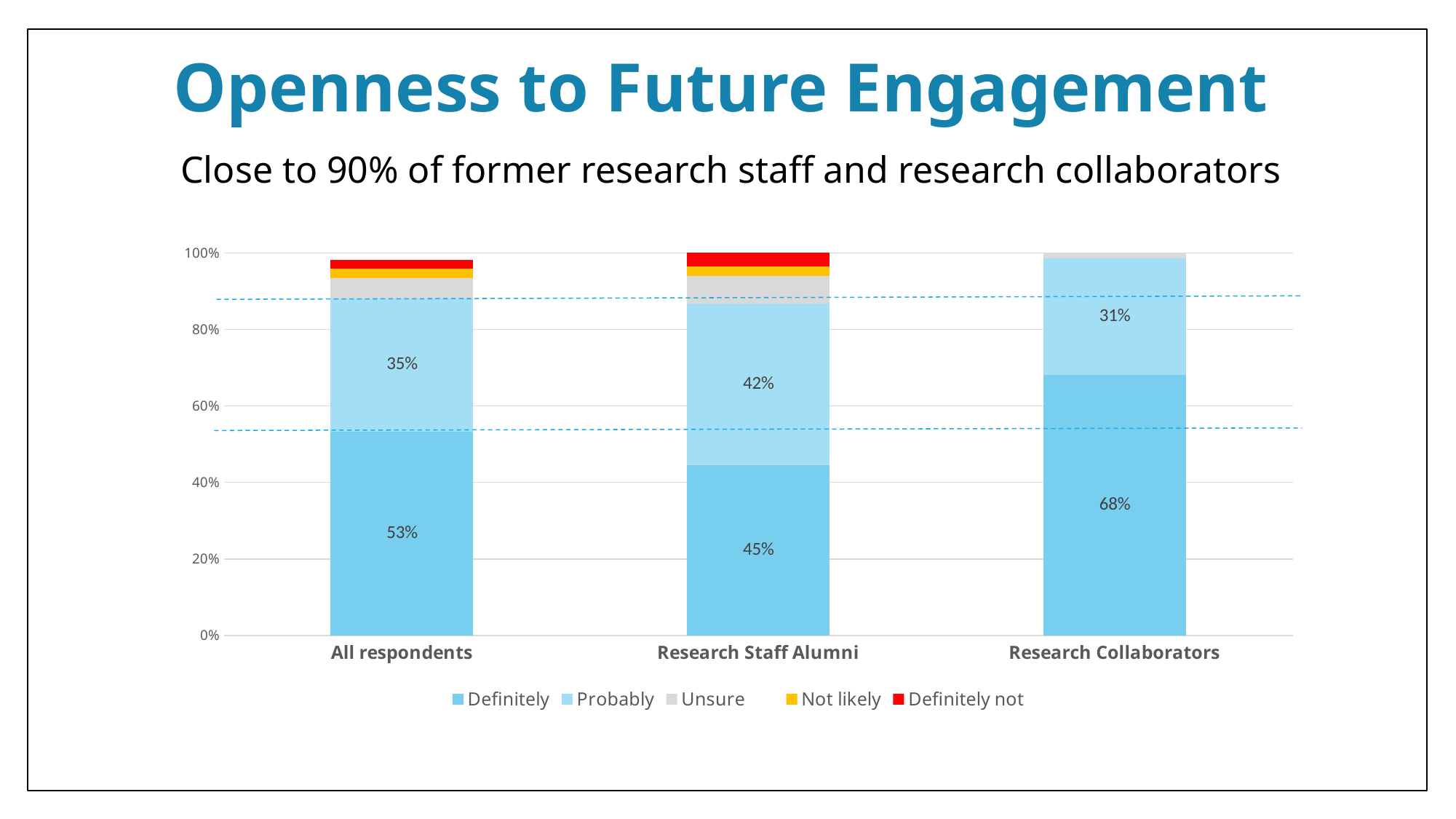
How many groups are shown on the x axis? 3 What percentage of Research Staff Alumni answered Probably? 42% What type of chart is shown on the slide? Stacked bar chart What percentage of Research Collaborators answered Probably? 31% Which group has the highest Definitely percentage? Research Collaborators For All respondents, which is larger: the Definitely share or the Probably share? Definitely What percentage of Research Collaborators answered Definitely? 68% What percentage of All respondents answered Definitely? 53% How many series does the legend list? 5 What is the combined Definitely and Probably share for Research Staff Alumni? 87% Which group has the lowest Definitely percentage? Research Staff Alumni How many percentage points higher is the Definitely share for Research Collaborators than for All respondents? 15 percentage points